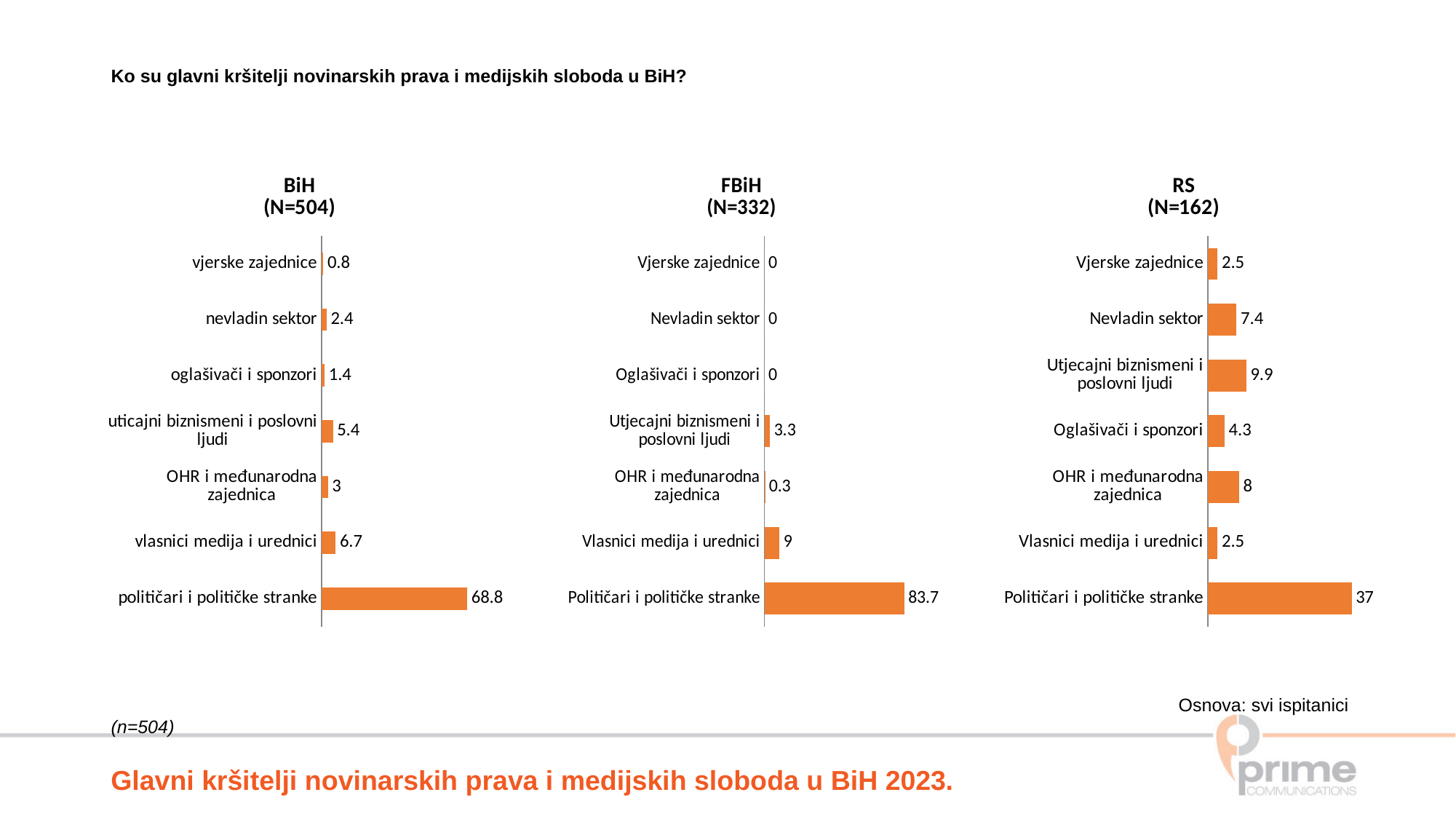
In the FBiH (N=332) chart, how many categories have a value of 0? 3 In the BiH (N=504) chart, what is the value for političari i političke stranke? 68.8 In the RS (N=162) chart, what is the value for Nevladin sektor? 7.4 In the RS (N=162) chart, which category has the highest value? Političari i političke stranke In the RS (N=162) chart, which is larger: Utjecajni biznismeni i poslovni ljudi or OHR i međunarodna zajednica? Utjecajni biznismeni i poslovni ljudi In the FBiH (N=332) chart, what is the value for Vlasnici medija i urednici? 9 How many categories are shown in the FBiH (N=332) chart? 7 In the FBiH (N=332) chart, what is the difference between Političari i političke stranke and Vlasnici medija i urednici? 74.7 In the BiH (N=504) chart, which category has the lowest value? vjerske zajednice In the RS (N=162) chart, what is the value for Oglašivači i sponzori? 4.3 What type of chart is the BiH (N=504) chart? Bar chart What is the title of the slide's question above the charts? Ko su glavni kršitelji novinarskih prava i medijskih sloboda u BiH?